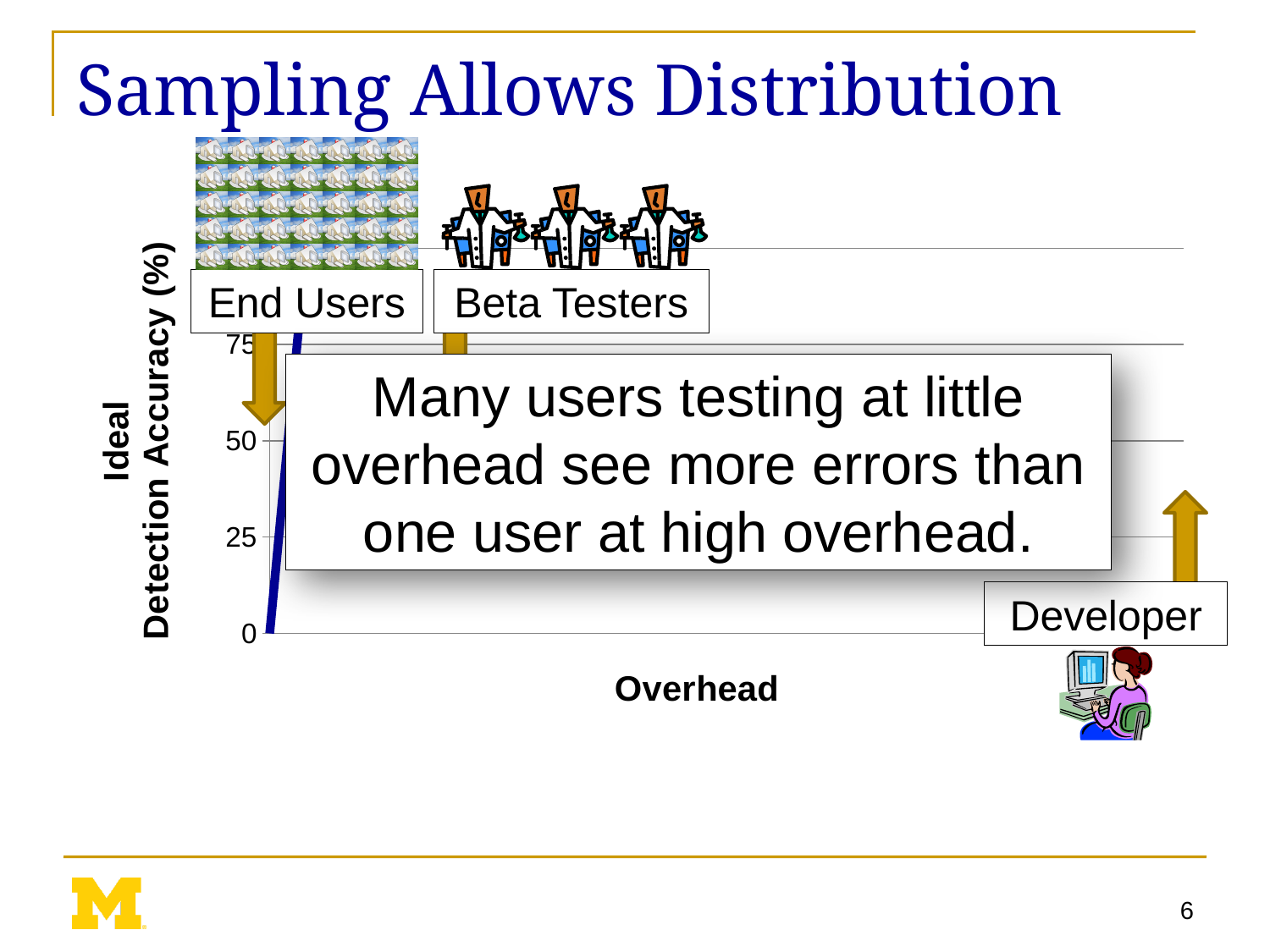
What is the interval between consecutive tick labels on the vertical axis of the chart? 25 Starting from the origin, does the plotted line rise or fall as overhead increases? rise What is the title of the horizontal axis of the chart? Overhead How many tick labels are printed on the vertical axis of the chart? 4 What is the highest tick label printed on the vertical axis of the chart? 75 What is the title of the vertical axis of the chart? Ideal Detection Accuracy (%) What is the lowest tick label printed on the vertical axis of the chart? 0 What kind of chart is shown on the slide? line chart